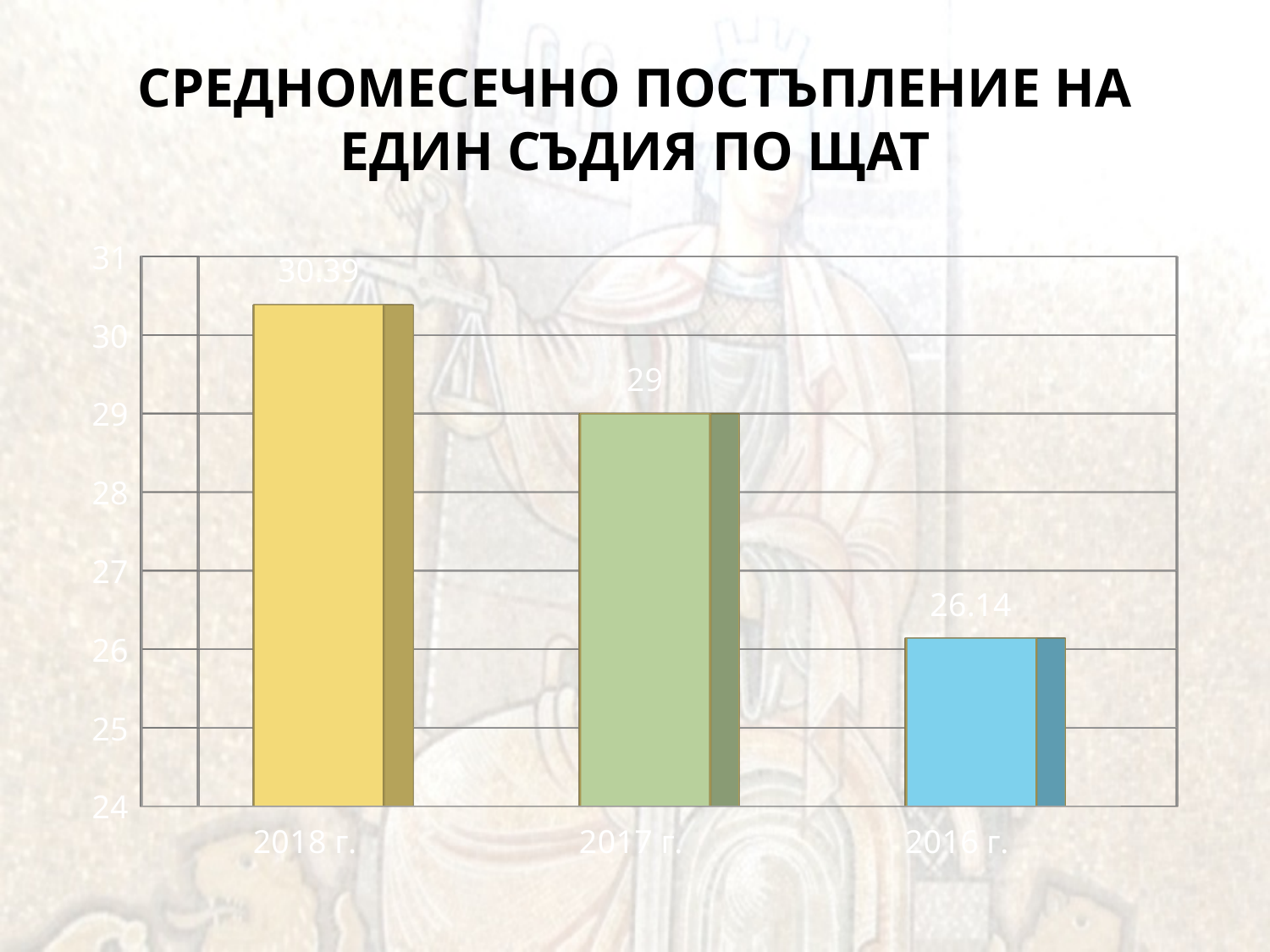
How many years are shown on the chart? 3 What is the title of the chart? СРЕДНОМЕСЕЧНО ПОСТЪПЛЕНИЕ НА ЕДИН СЪДИЯ ПО ЩАТ What kind of chart is shown on the slide? bar chart Which year has the lowest value? 2016 г. What is the value for 2016 г.? 26.14 What is the difference between the values for 2018 г. and 2016 г.? 4.25 Is the value for 2016 г. greater or less than 27? less Which is larger, the value for 2017 г. or the value for 2016 г.? 2017 г. Which year has the highest value? 2018 г. What is the value for 2018 г.? 30.39 What is the value for 2017 г.? 29 What is the difference between the values for 2018 г. and 2017 г.? 1.39